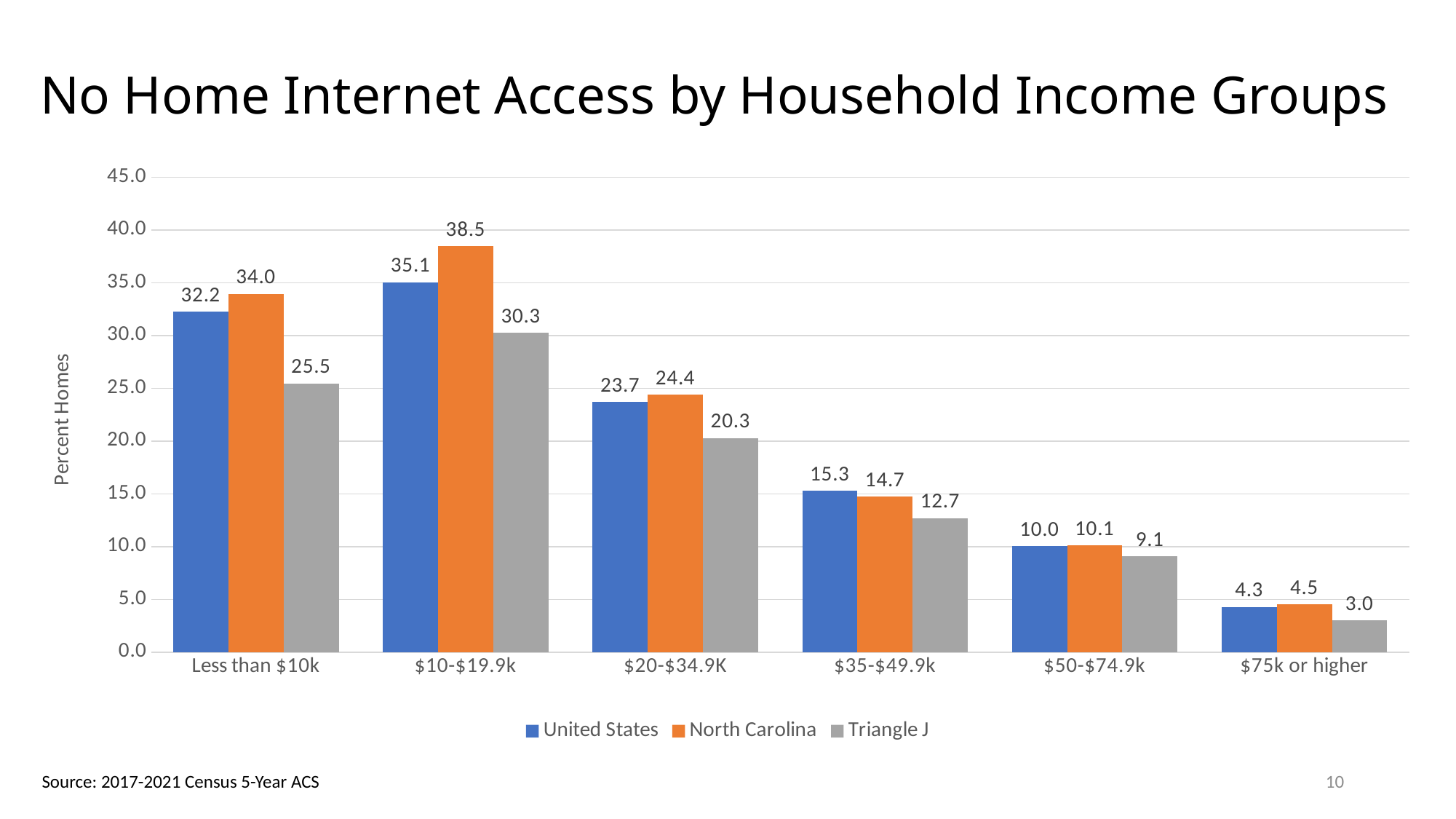
Do the Triangle J values rise or fall as income groups increase along the x axis? Fall What is the value for Triangle J in the Less than $10k income group? 25.5 What is the value for United States in the $35-$49.9k income group? 15.3 Which income group has the highest value for the United States series? $10-$19.9k How many series does the legend list? 3 What is the difference between the North Carolina and Triangle J values in the $20-$34.9K income group? 4.1 Which income group has the lowest value for the Triangle J series? $75k or higher Is the value for North Carolina in the Less than $10k income group greater or less than 30.0? greater How many income groups are shown on the x axis? 6 In the $50-$74.9k income group, which is larger: the United States value or the Triangle J value? United States What is the value for North Carolina in the $10-$19.9k income group? 38.5 What kind of chart is shown on the slide? Bar chart